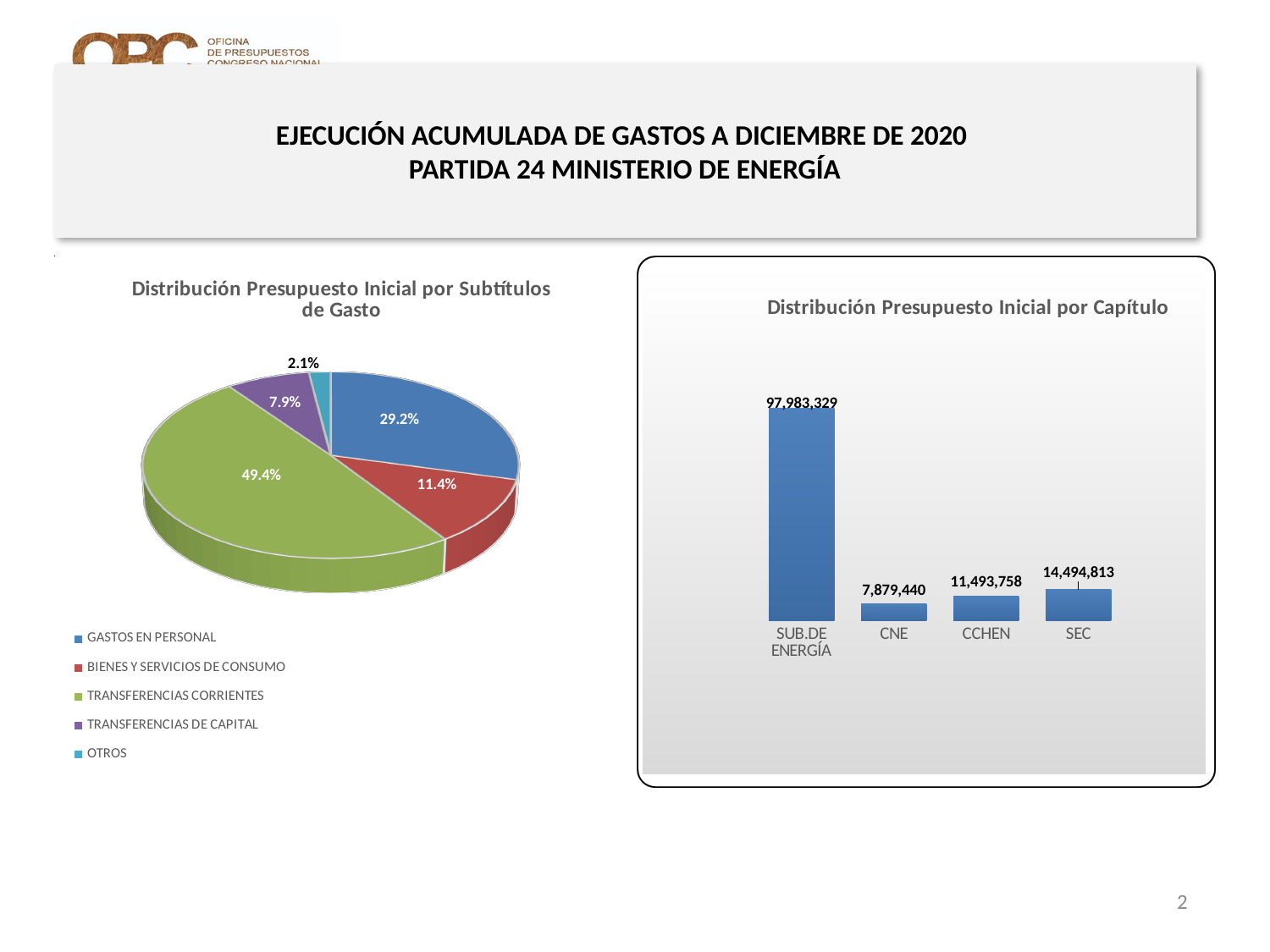
What kind of chart is 'Distribución Presupuesto Inicial por Capítulo'? Bar chart In the chart 'Distribución Presupuesto Inicial por Capítulo', which category has the highest value? SUB.DE ENERGÍA In the chart 'Distribución Presupuesto Inicial por Capítulo', which category has the lowest value? CNE In the chart 'Distribución Presupuesto Inicial por Capítulo', how many categories are shown? 4 How many entries does the legend of the pie chart 'Distribución Presupuesto Inicial por Subtítulos de Gasto' list? 5 In the chart 'Distribución Presupuesto Inicial por Capítulo', what is the value for SUB.DE ENERGÍA? 97,983,329 In the pie chart 'Distribución Presupuesto Inicial por Subtítulos de Gasto', which category has the smallest slice? OTROS In the pie chart 'Distribución Presupuesto Inicial por Subtítulos de Gasto', which is larger: BIENES Y SERVICIOS DE CONSUMO or TRANSFERENCIAS DE CAPITAL? BIENES Y SERVICIOS DE CONSUMO In the pie chart 'Distribución Presupuesto Inicial por Subtítulos de Gasto', what share does GASTOS EN PERSONAL have? 29.2% In the pie chart 'Distribución Presupuesto Inicial por Subtítulos de Gasto', what share does TRANSFERENCIAS CORRIENTES have? 49.4% In the chart 'Distribución Presupuesto Inicial por Capítulo', what is the difference between the values for SEC and CCHEN? 3,001,055 In the chart 'Distribución Presupuesto Inicial por Capítulo', what is the value for CNE? 7,879,440